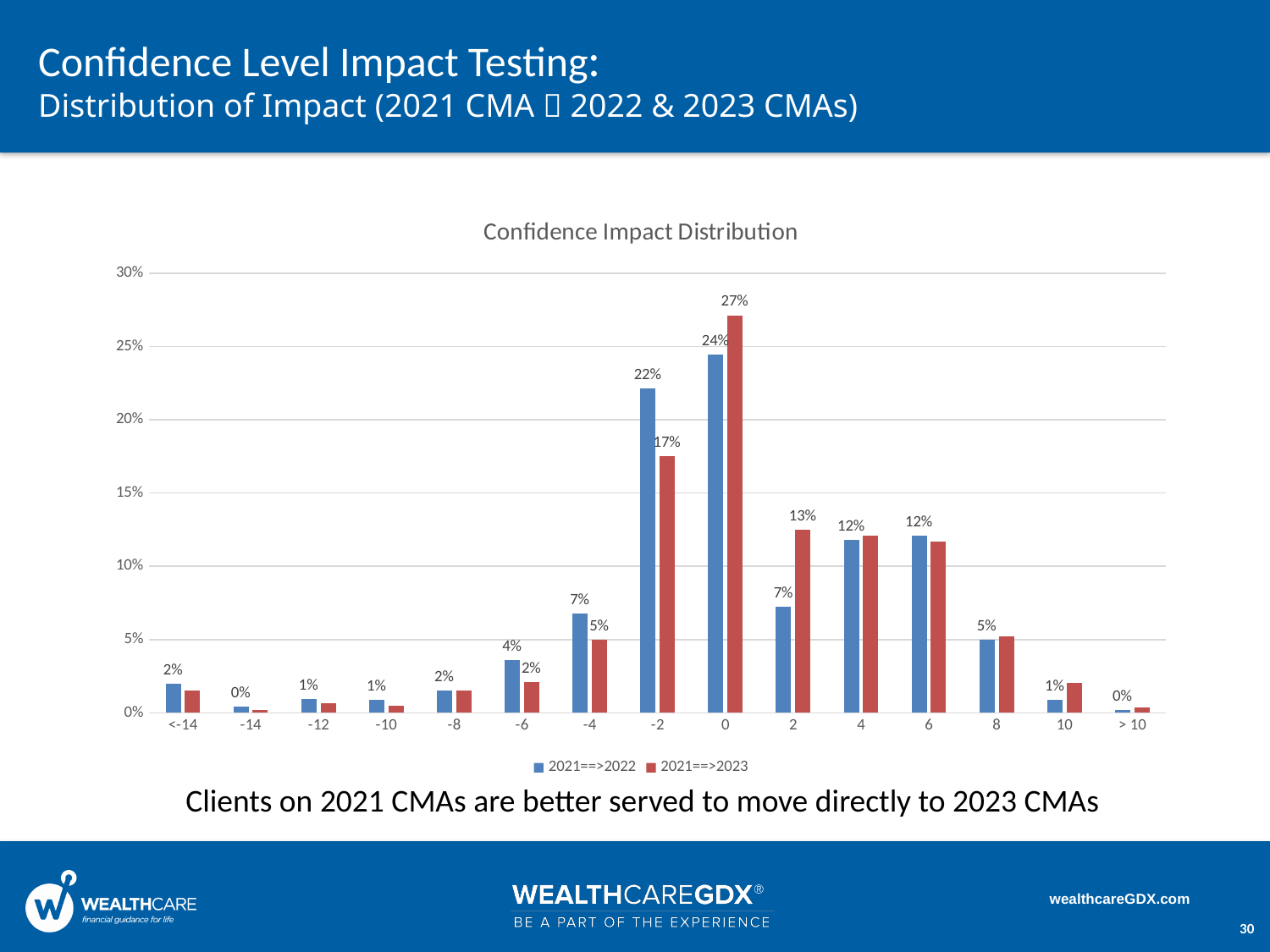
What is the value for the 2021==>2023 series at category 2? 13% Which category has the highest value for the 2021==>2022 series? 0 At category 2, which series has the larger value, 2021==>2022 or 2021==>2023? 2021==>2023 What kind of chart is shown on the slide? Bar chart What is the value for the 2021==>2023 series at category 0? 27% What are the two legend entries in the Confidence Impact Distribution chart? 2021==>2022 and 2021==>2023 How many series does the legend list in the Confidence Impact Distribution chart? 2 Is the value for the 2021==>2023 series at category 4 greater or less than 10%? greater What is the value for the 2021==>2022 series at category 0? 24% What is the value for the 2021==>2022 series at category -2? 22% What is the difference between the 2021==>2022 and 2021==>2023 values at category -2? 5 percentage points How many categories are shown along the x axis of the Confidence Impact Distribution chart? 15